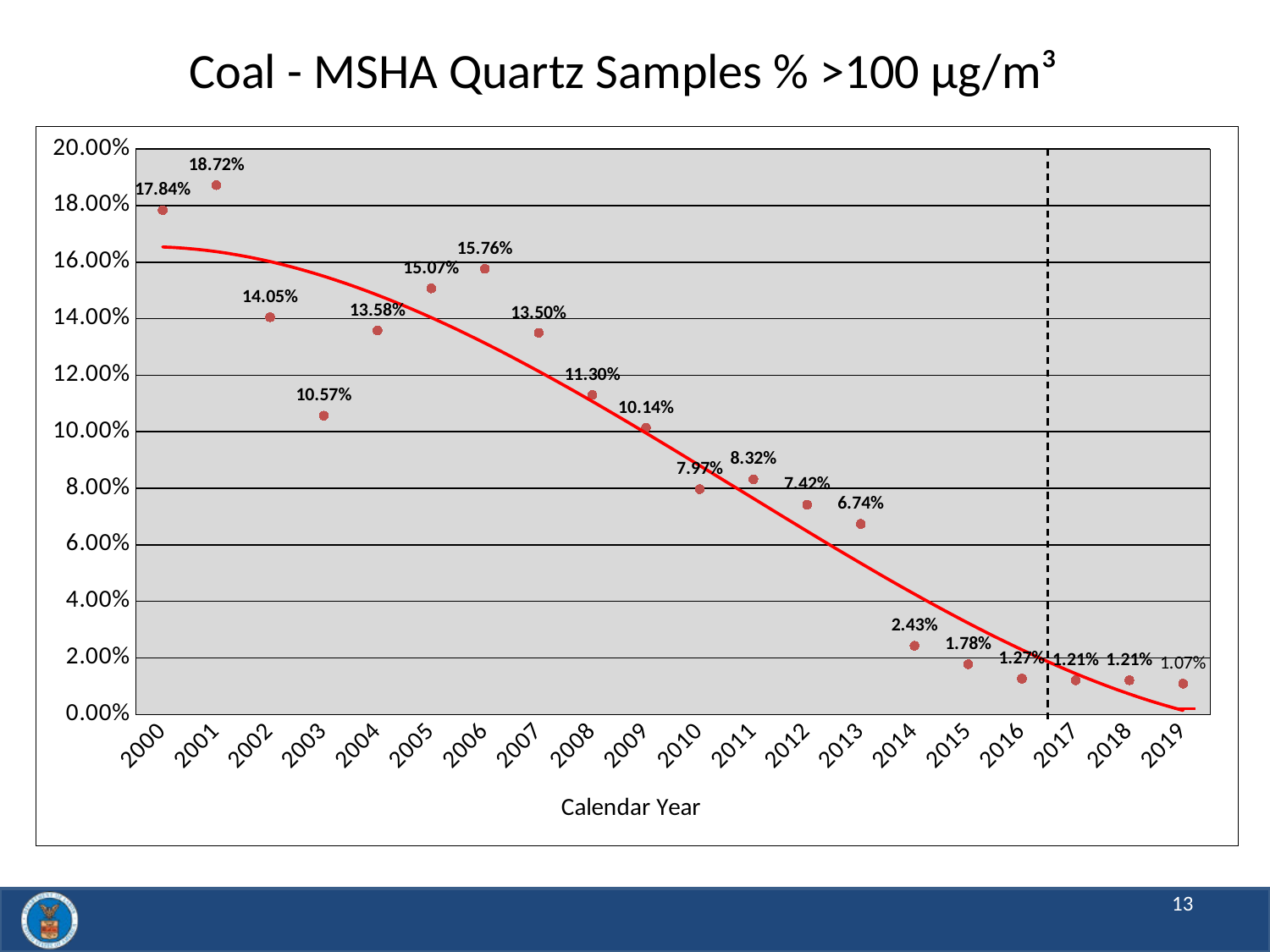
What is the difference between the values for 2000 and 2019? 16.77% Which year has the highest value? 2001 What is the difference between the values for 2001 and 2000? 0.88% Which year has the larger value, 2010 or 2011? 2011 What is the value for 2009? 10.14% How many years are plotted on the chart? 20 Do the values generally rise or fall from 2000 to 2019? fall What is the value for 2019? 1.07% What is the value for 2001? 18.72% What is the title of the chart? Coal - MSHA Quartz Samples % >100 µg/m³ Which year has the lowest value? 2019 Is the value for 2014 greater or less than 4.00%? less